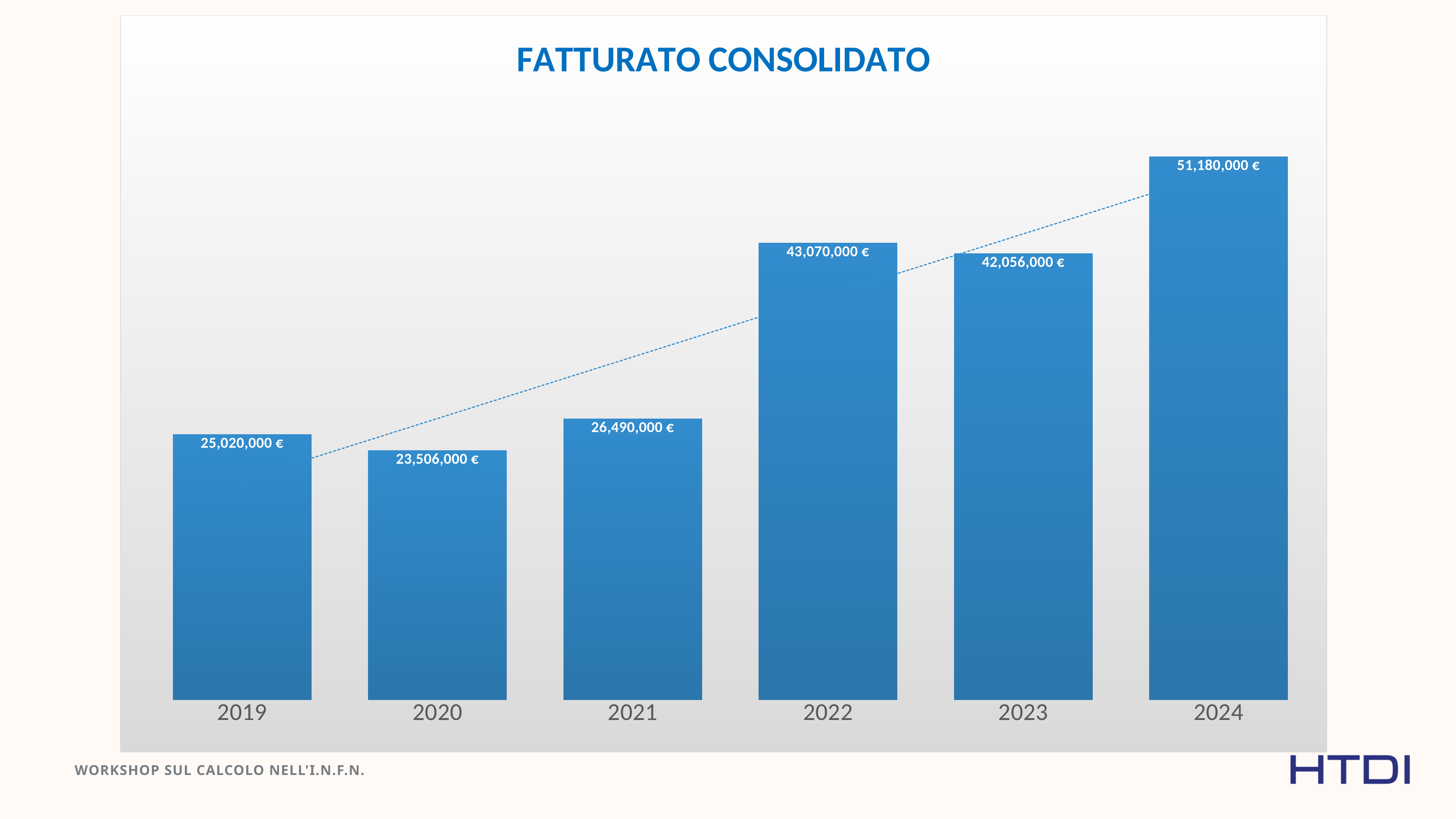
What kind of chart is this? bar chart Which is larger, the value for 2022 or the value for 2023? 2022 What is the title of the chart? FATTURATO CONSOLIDATO What is the value for 2022? 43,070,000 € What is the difference between the values for 2024 and 2023? 9,124,000 € Which year has the highest value? 2024 How many years are shown on the x axis? 6 Which year has the lowest value? 2020 What is the value for 2019? 25,020,000 € What is the value for 2024? 51,180,000 € Does the value fall or rise from 2019 to 2020? fall What is the difference between the values for 2022 and 2021? 16,580,000 €